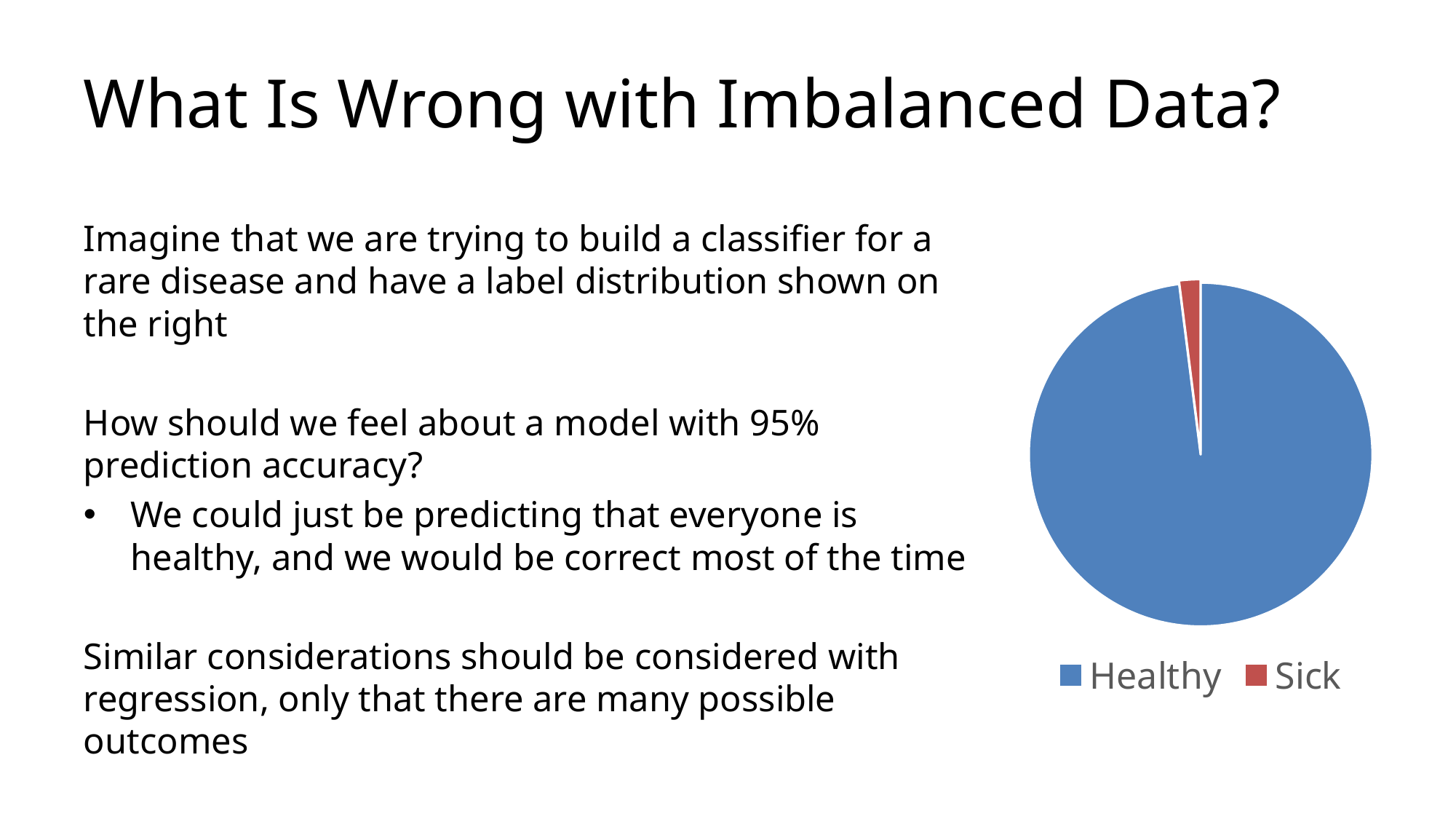
How many categories does the pie chart show? 2 What colour is the Healthy slice in the pie chart? blue What colour is the Sick slice in the pie chart? red Which category has the largest slice in the pie chart? Healthy Which category has the smallest slice in the pie chart? Sick What kind of chart is shown on the slide? pie chart How many entries does the legend of the pie chart list? 2 Which slice is larger in the pie chart, Healthy or Sick? Healthy